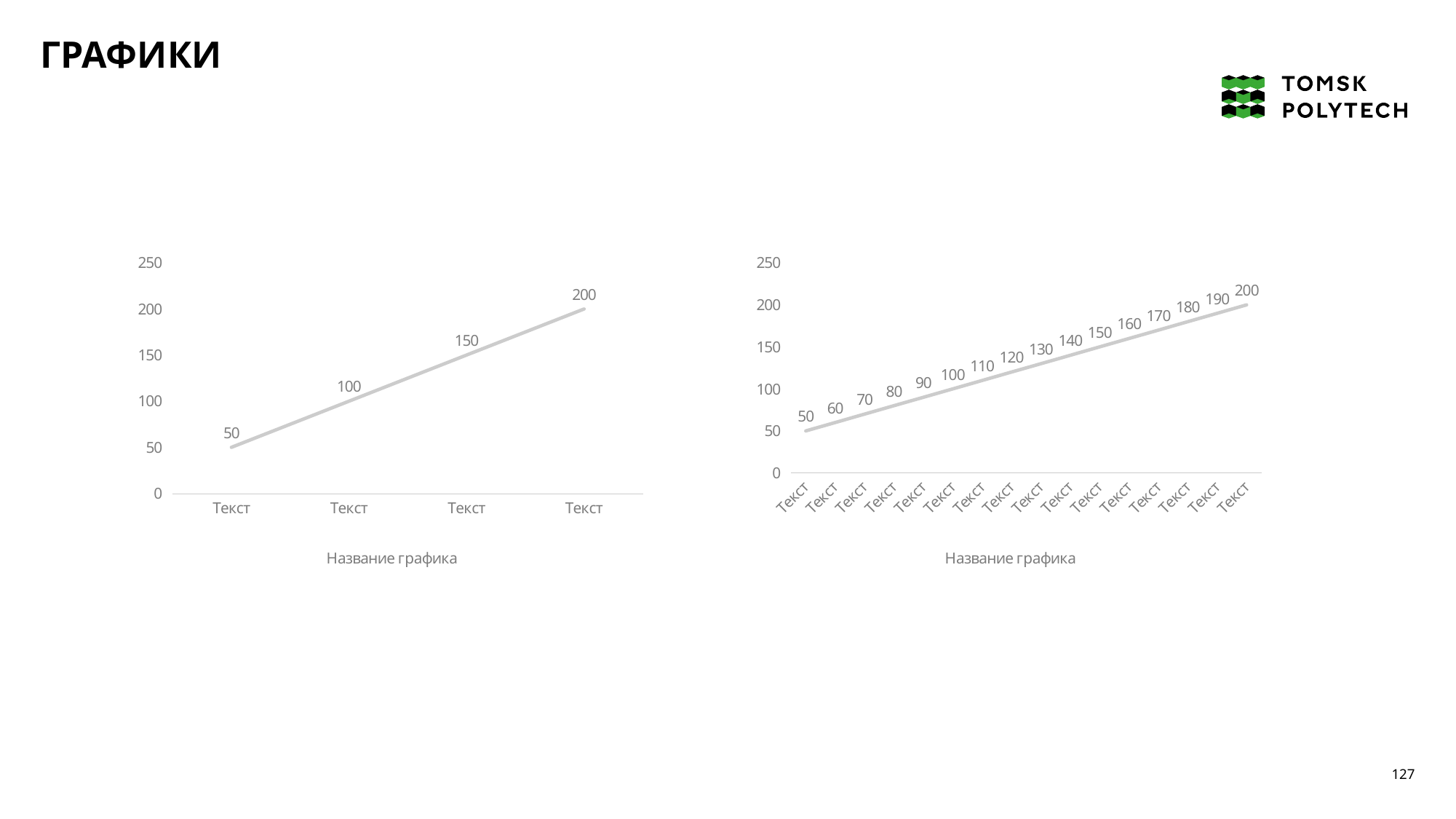
In the chart on the right, what is the difference between the second point (60) and the first point (50)? 10 In the chart on the right, what is the highest value plotted? 200 What is the title shown below the chart on the right? Название графика In the chart on the left, what is the value of the last point? 200 In the chart on the right, what is the lowest value plotted? 50 In the chart on the left, how many data points are plotted? 4 In the chart on the right, how many data points are plotted? 16 What kind of chart is the chart on the left of the slide? line chart What kind of chart is the chart on the right of the slide? line chart In the chart on the left, do the values rise or fall along the x axis? rise In the chart on the left, what is the difference between the last point and the first point? 150 In the chart on the left, what is the value of the first point? 50